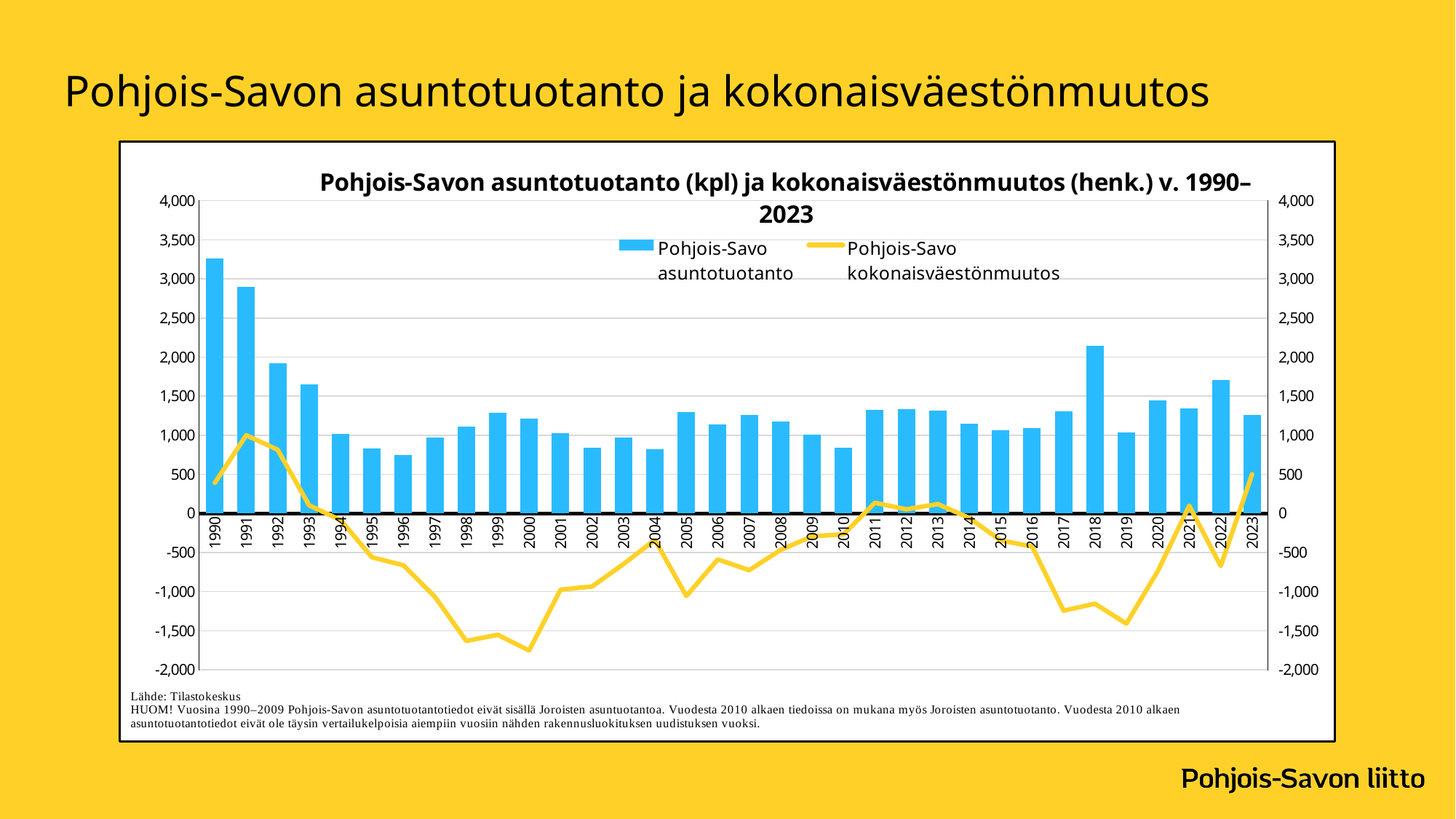
Is the asuntotuotanto bar for 1990 greater or less than 3,000? greater What kind of chart is shown on the slide? A combined bar and line chart Do the asuntotuotanto bars rise or fall from 1990 to 1996? fall Is the asuntotuotanto bar for 2018 greater or less than 2,000? greater In which year does the Pohjois-Savo kokonaisväestönmuutos line reach its lowest point? 2000 Which year has the lowest bar for Pohjois-Savo asuntotuotanto? 1996 Is the kokonaisväestönmuutos value for 2019 greater or less than -1,000? less Which year has the larger asuntotuotanto bar, 2018 or 2022? 2018 Which year has the highest bar for Pohjois-Savo asuntotuotanto? 1990 How many series does the legend list? 2 How many years are plotted along the x axis? 34